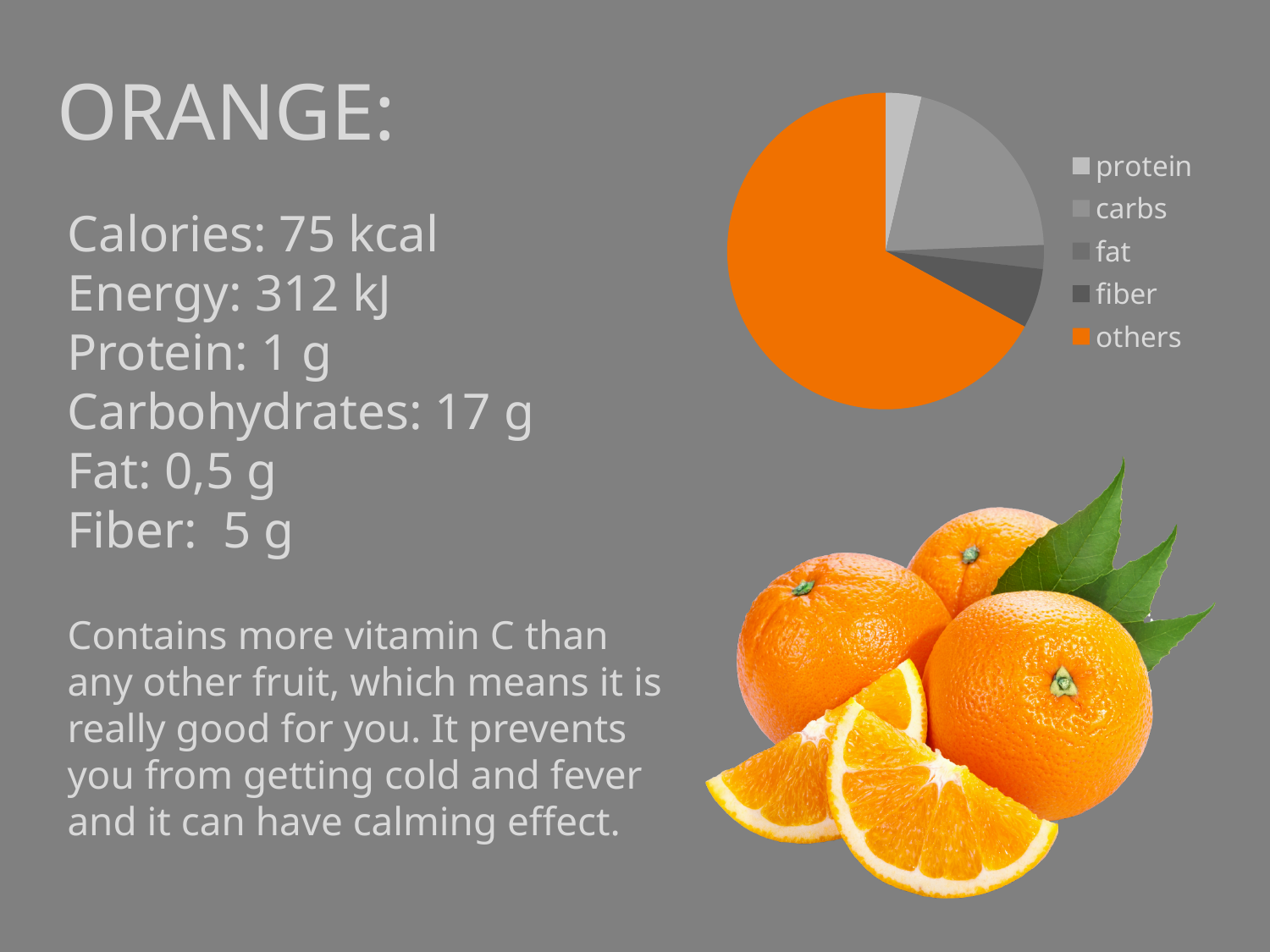
Which category has the largest slice in the pie chart? others Which is larger in the pie chart, the carbs slice or the protein slice? carbs What kind of chart is shown on the slide? pie chart Which is larger in the pie chart, the others slice or the carbs slice? others Which legend entry is listed first in the pie chart's legend? protein Which is larger in the pie chart, the carbs slice or the fiber slice? carbs What colour is the 'others' slice in the pie chart? orange How many slices does the pie chart have? 5 How many categories does the pie chart's legend list? 5